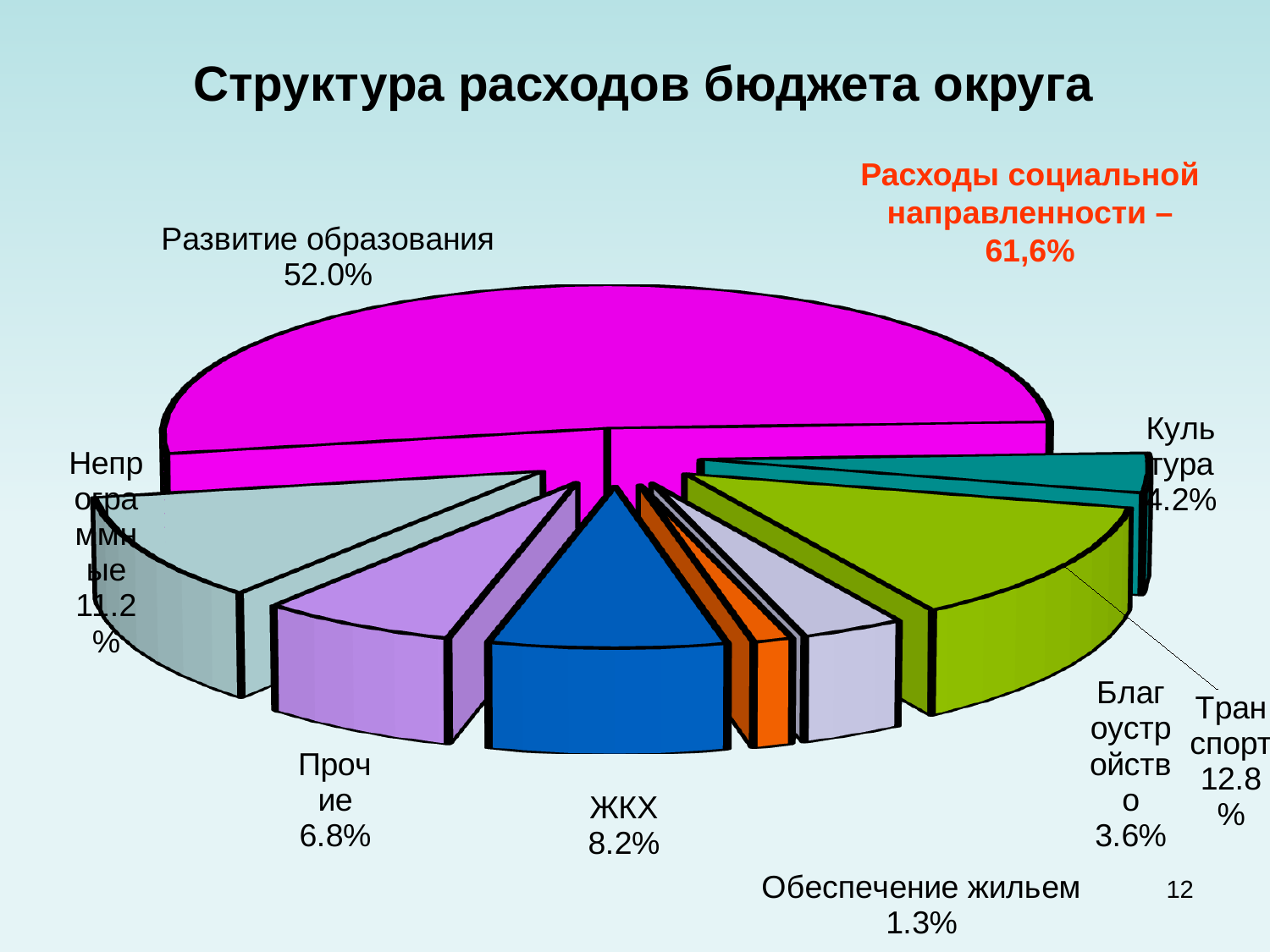
What kind of chart is shown on the slide? pie chart What share is shown for Транспорт? 12.8% Which category has the largest share of the pie? Развитие образования What share of the budget expenditure goes to Развитие образования? 52.0% Which category has the smallest share of the pie? Обеспечение жильем Which is larger, the share for Прочие or the share for Культура? Прочие What share is shown for ЖКХ? 8.2% How many slices does the pie chart have? 8 What is the title of the chart? Структура расходов бюджета округа What share is shown for Благоустройство? 3.6% What is the difference between the shares for Транспорт and Непрограммные? 1.6% What share is shown for Обеспечение жильем? 1.3%